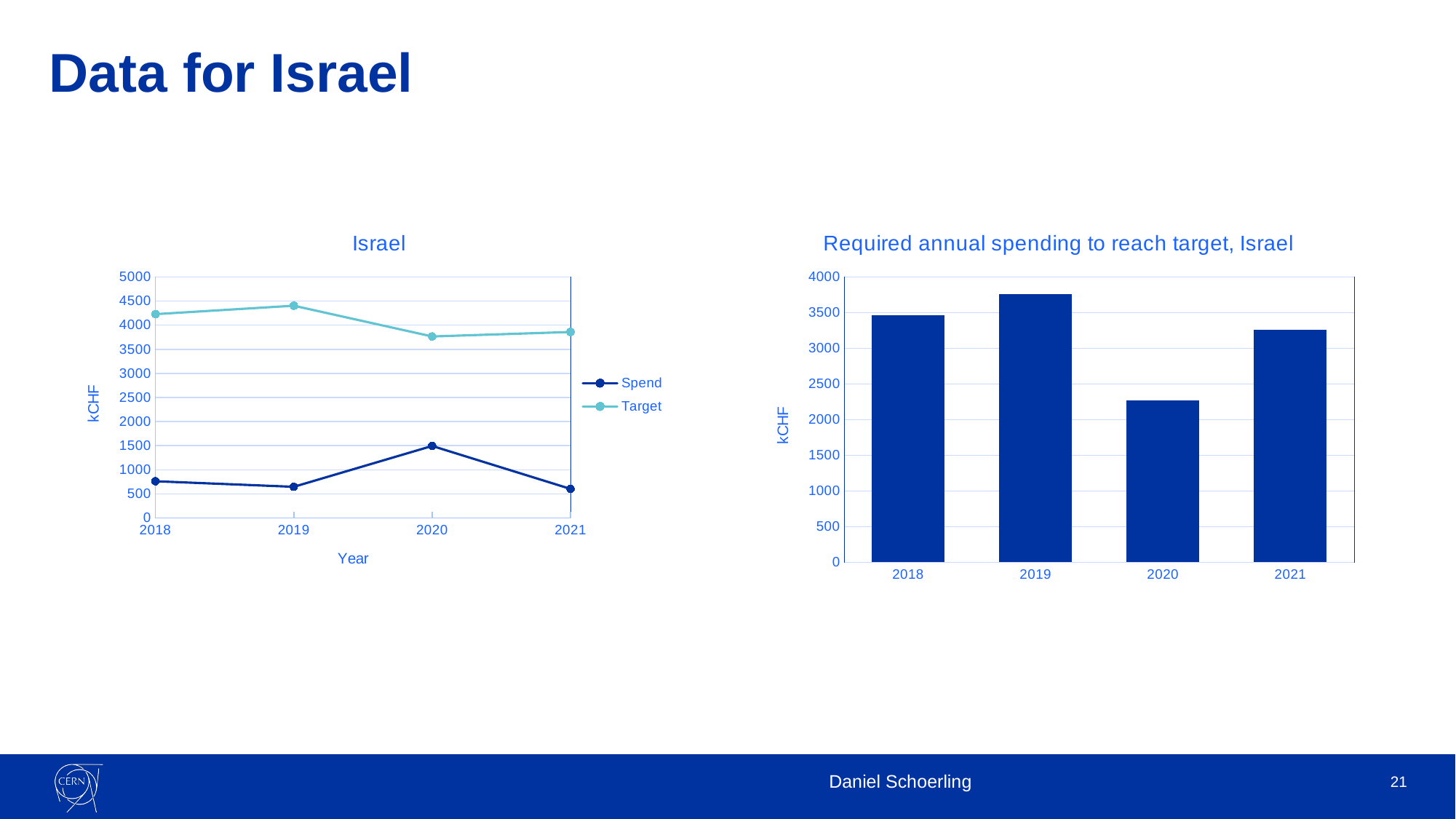
In the chart titled "Israel", is the Spend value for 2020 greater or less than 1000? greater In the chart titled "Required annual spending to reach target, Israel", which year has the lowest bar? 2020 In the chart titled "Required annual spending to reach target, Israel", which is larger, the value for 2018 or the value for 2021? 2018 In the chart titled "Required annual spending to reach target, Israel", how many years are shown on the x axis? 4 What kind of chart is the chart titled "Required annual spending to reach target, Israel"? bar chart What kind of chart is the chart titled "Israel" on the left of the slide? line chart In the chart titled "Israel", in which year is the Spend value highest? 2020 In the chart titled "Israel", how many series does the legend list? 2 In the chart titled "Required annual spending to reach target, Israel", is the value for 2020 greater or less than 2500? less In the chart titled "Israel", in which year is the Target value highest? 2019 In the chart titled "Israel", is the Target value for 2020 greater or less than 4000? less In the chart titled "Required annual spending to reach target, Israel", which year has the highest bar? 2019